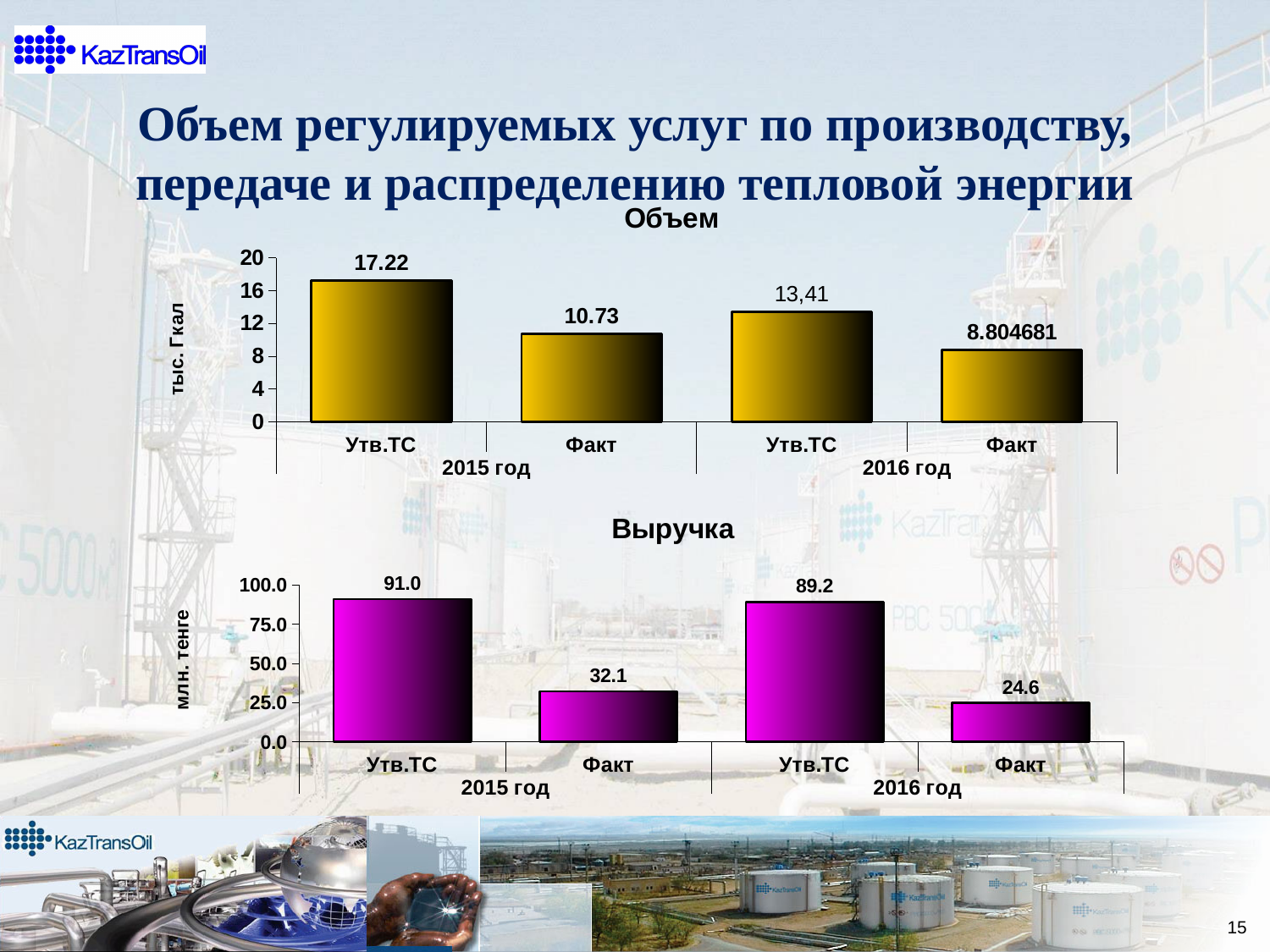
In the 'Объем' chart, which bar is the highest? Утв.ТС 2015 год In the 'Объем' chart, what is the value for Факт in 2016 год? 8.804681 In the 'Выручка' chart, which is larger: Факт in 2015 год or Факт in 2016 год? Факт 2015 год In the 'Объем' chart, what is the value for Утв.ТС in 2015 год? 17.22 In the 'Выручка' chart, what is the value for Факт in 2015 год? 32.1 In the 'Выручка' chart, what is the difference between Утв.ТС and Факт in 2015 год? 58.9 What is the y-axis label of the 'Объем' chart? тыс. Гкал In the 'Объем' chart, which bar is the lowest? Факт 2016 год In the 'Выручка' chart, what is the value for Утв.ТС in 2016 год? 89.2 In the 'Объем' chart, what is the value for Утв.ТС in 2016 год? 13,41 What type of chart is the 'Выручка' chart? Bar chart In the 'Объем' chart, how many bars are plotted? 4